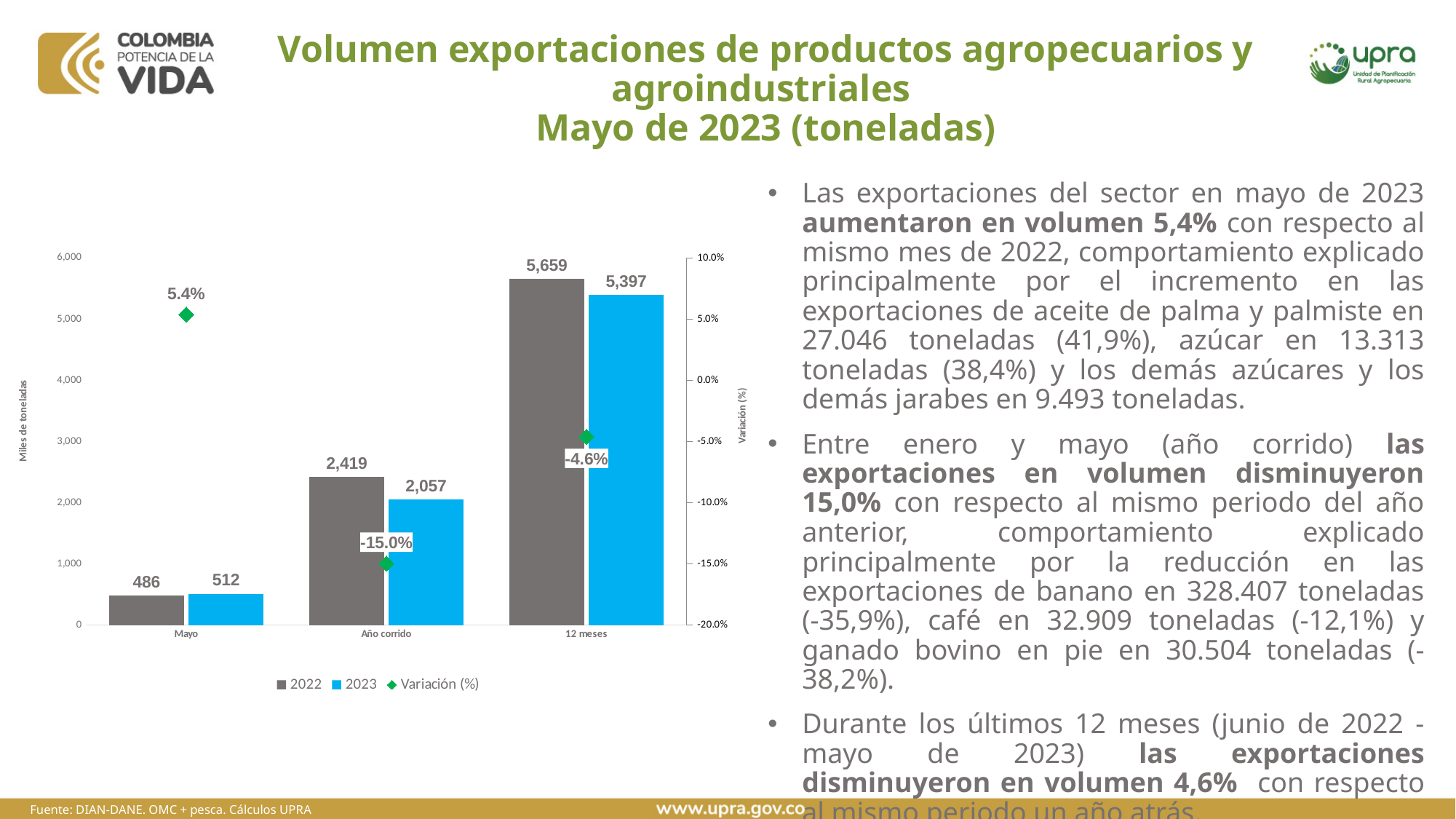
Which is larger for Mayo, the 2022 value or the 2023 value? 2023 How many categories are shown on the x axis? 3 What is the Variación (%) value for 12 meses? -4.6% What is the 2022 value for Mayo? 486 What is the label of the left vertical axis? Miles de toneladas Is the 2023 value for Año corrido greater or less than 3,000? less What kind of chart is used for the 2022 and 2023 series? bar chart Which category has the lowest 2022 value? Mayo Which category has the highest 2023 value? 12 meses How many series does the legend list? 3 What is the difference between the 2022 and 2023 values for 12 meses? 262 What is the 2023 value for Año corrido? 2,057